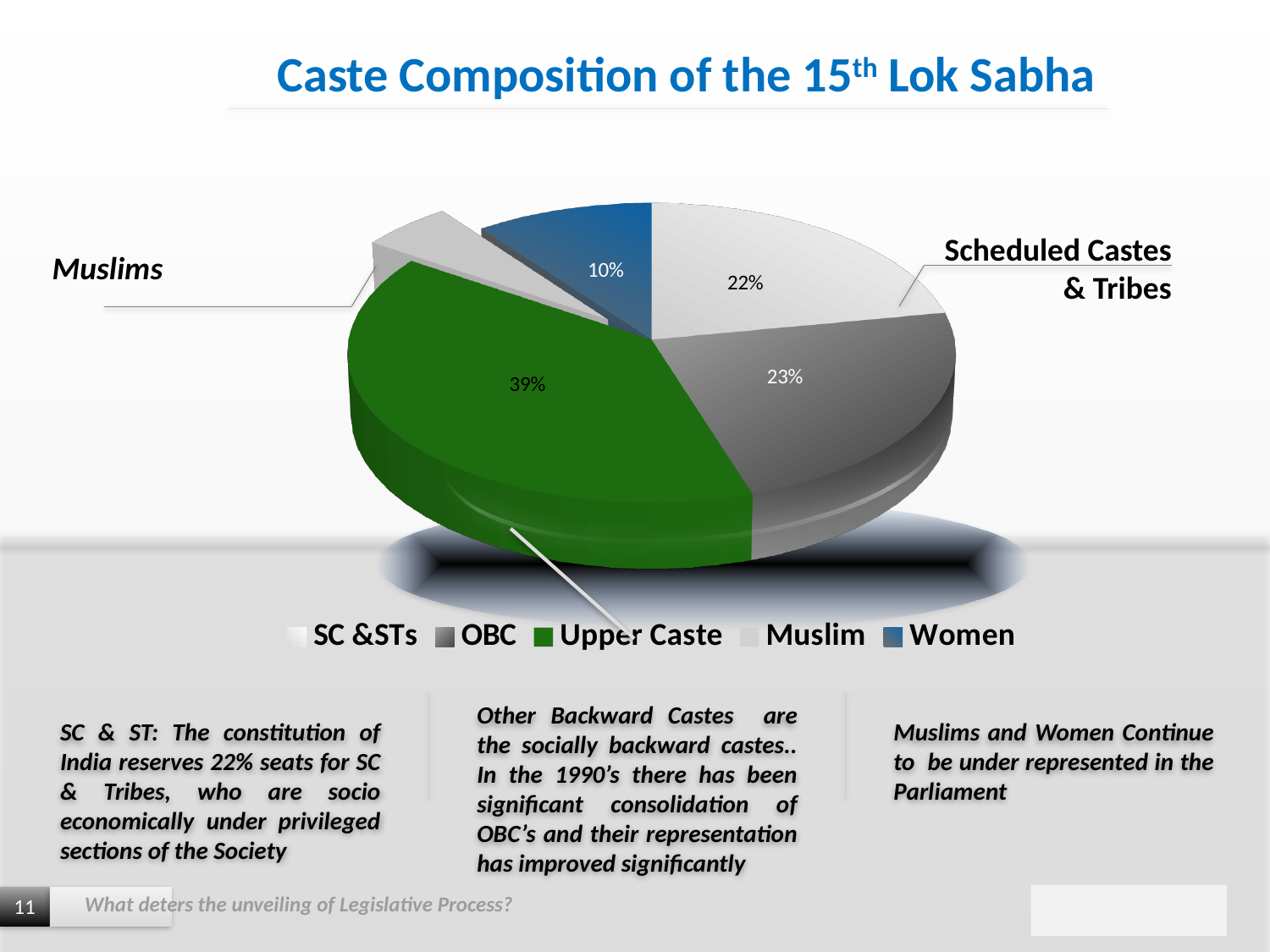
Which category has the largest slice of the pie? Upper Caste How many categories does the legend of the pie chart list? 5 Which category has the smallest slice of the pie? Muslim Which slice is larger, Upper Caste or OBC? Upper Caste What share of the pie is labelled for OBC? 23% By how many percentage points does the Upper Caste share exceed the OBC share? 16 percentage points What is the title of the chart? Caste Composition of the 15th Lok Sabha What share of the pie is labelled for Women? 10% What share of the pie is labelled for Upper Caste? 39% What colour is the Upper Caste slice in the pie chart? Green What share of the pie is labelled for SC &STs? 22% What kind of chart is shown on the slide? Pie chart